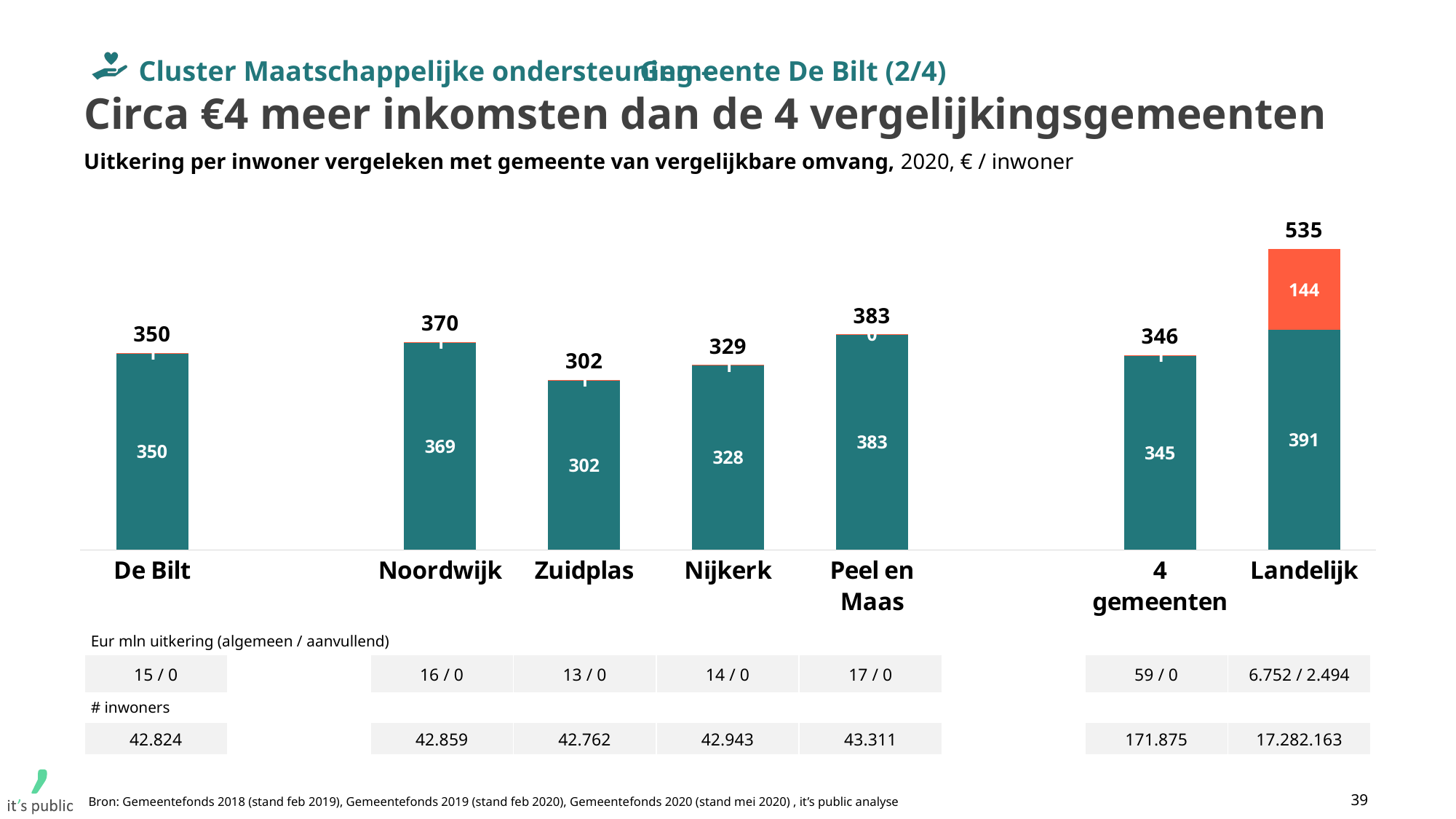
Which category has the lowest total value? Zuidplas What is the difference between the total for Peel en Maas and the total for Nijkerk? 54 How many categories are shown on the x axis of the chart? 7 What is the total value shown above the bar for De Bilt? 350 Which category has the highest total value? Landelijk What is the difference between the total for De Bilt and the total for 4 gemeenten? 4 What is the total value shown above the bar for Landelijk? 535 What is the sum of the teal segment (391) and the orange segment (144) in the Landelijk bar? 535 Which is larger, the total for Noordwijk or the total for Nijkerk? Noordwijk What kind of chart is shown on the slide? Stacked bar chart What is the value of the orange (aanvullend) segment in the Landelijk bar? 144 What is the value of the teal segment in the Noordwijk bar? 369